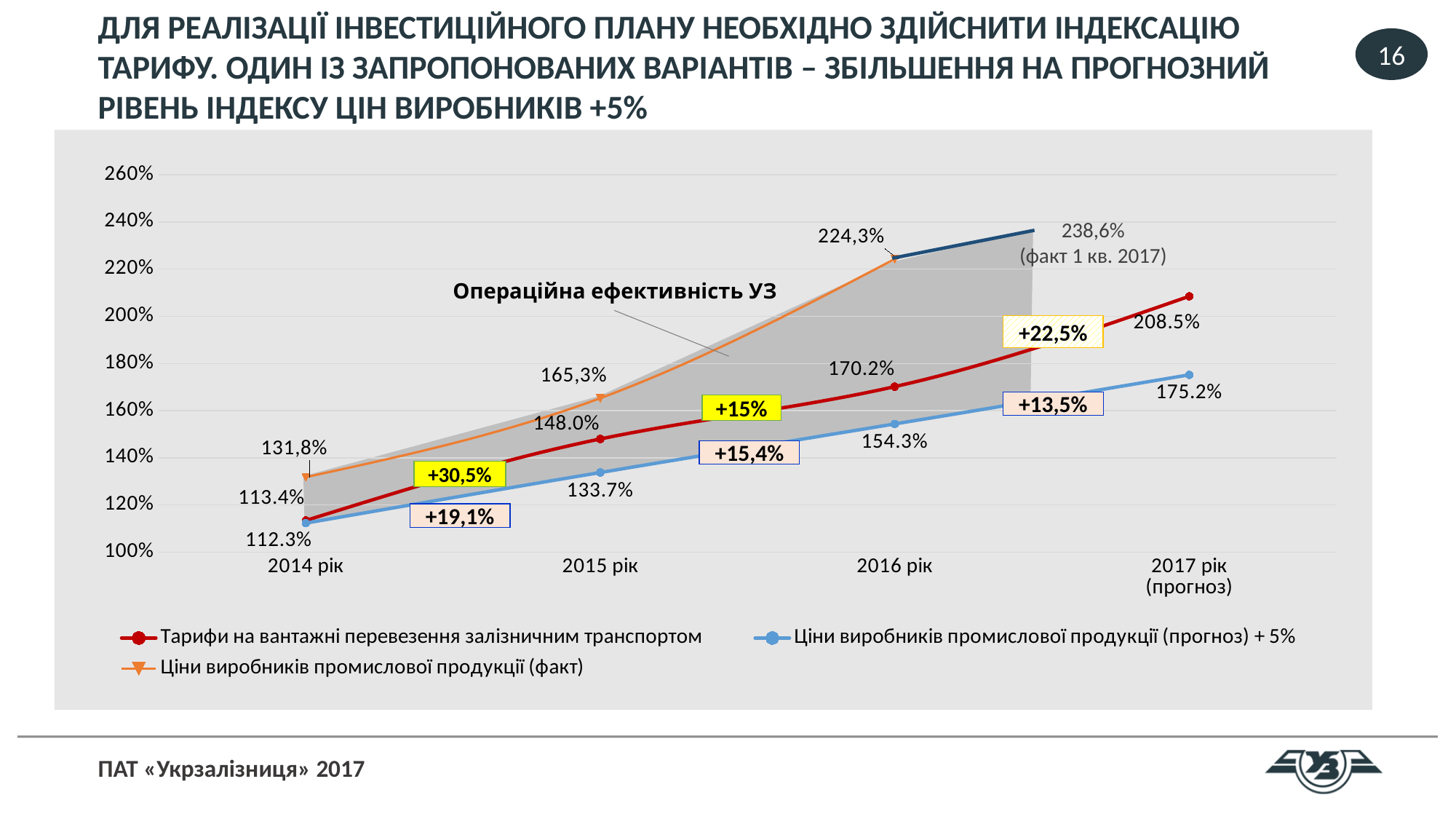
Which is larger in 2016 рік: 'Ціни виробників промислової продукції (факт)' or 'Тарифи на вантажні перевезення залізничним транспортом'? Ціни виробників промислової продукції (факт) Does 'Ціни виробників промислової продукції (прогноз) + 5%' rise or fall from 2014 рік to 2017 рік (прогноз)? Rise What is the value of 'Ціни виробників промислової продукції (прогноз) + 5%' for 2017 рік (прогноз)? 175.2% How many years are shown on the x axis? 4 How many series does the legend list? 3 What type of chart is shown on the slide? Line chart What is the value of 'Тарифи на вантажні перевезення залізничним транспортом' for 2016 рік? 170.2% In which year is 'Тарифи на вантажні перевезення залізничним транспортом' lowest? 2014 рік What growth percentage is shown in the yellow box between 2014 рік and 2015 рік for the tariff series? +30,5% What is the value of 'Ціни виробників промислової продукції (факт)' for 2015 рік? 165,3% In which year is 'Ціни виробників промислової продукції (факт)' highest? 2016 рік What is the difference between 'Тарифи на вантажні перевезення залізничним транспортом' and 'Ціни виробників промислової продукції (прогноз) + 5%' in 2017 рік (прогноз)? 33.3 percentage points